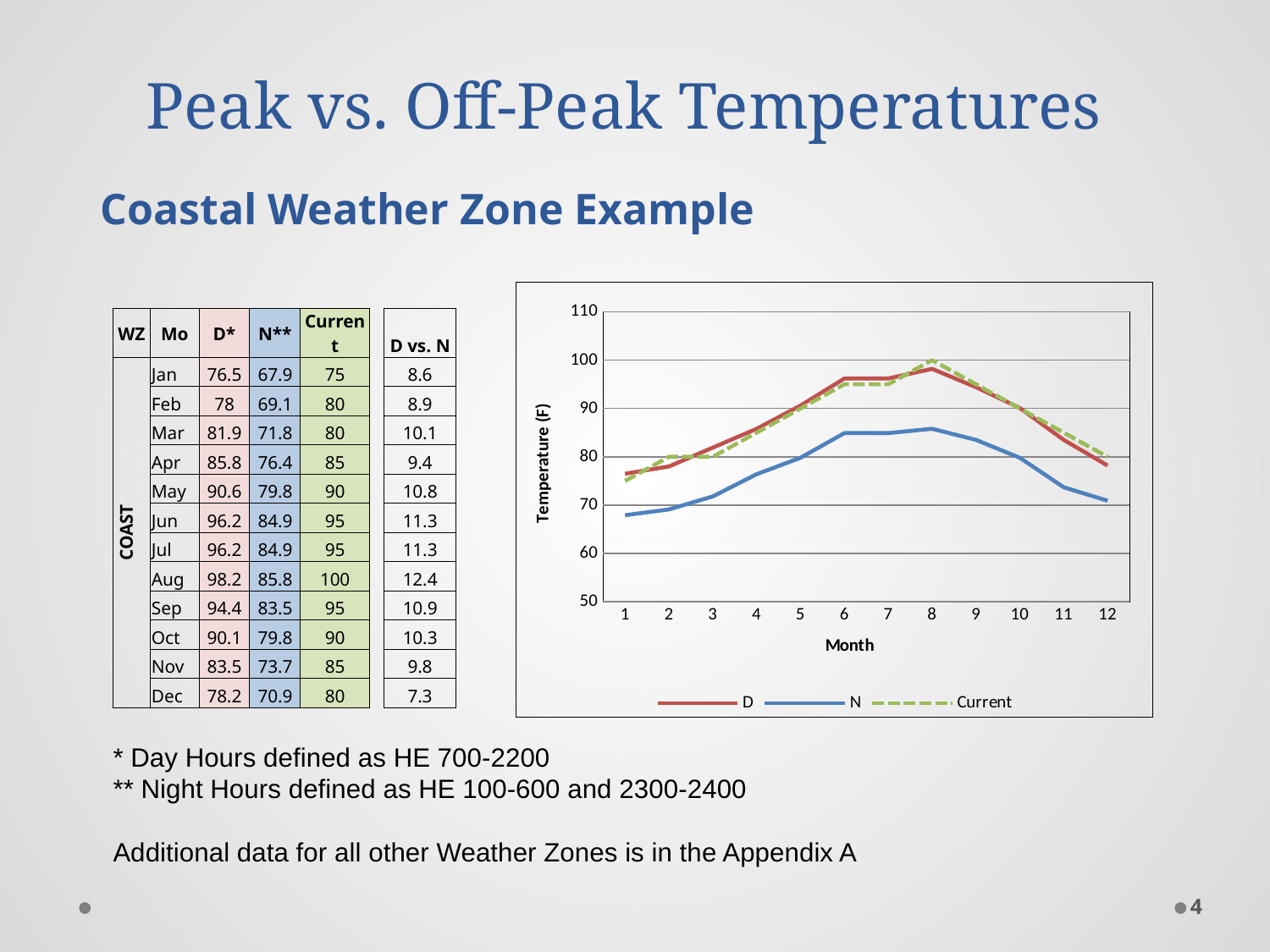
At month 8, which series has the larger value, D or N? D According to the table on the slide, what is the Current value for Aug (month 8)? 100 Is the value of the N series at month 6 greater or less than 90? less In which month is the N series at its lowest value? Month 1 (Jan) What is the difference between the D and N values for Aug, as shown in the D vs. N column? 12.4 In which month does the D series reach its highest value? Month 8 (Aug) What is the title of the chart's vertical axis? Temperature (F) According to the table on the slide, what is the D value for Aug (month 8)? 98.2 What kind of chart is shown on the slide? Line chart How many months are plotted along the x axis of the chart? 12 Is the value of the D series at month 8 greater or less than 90? greater How many series does the chart legend list? 3